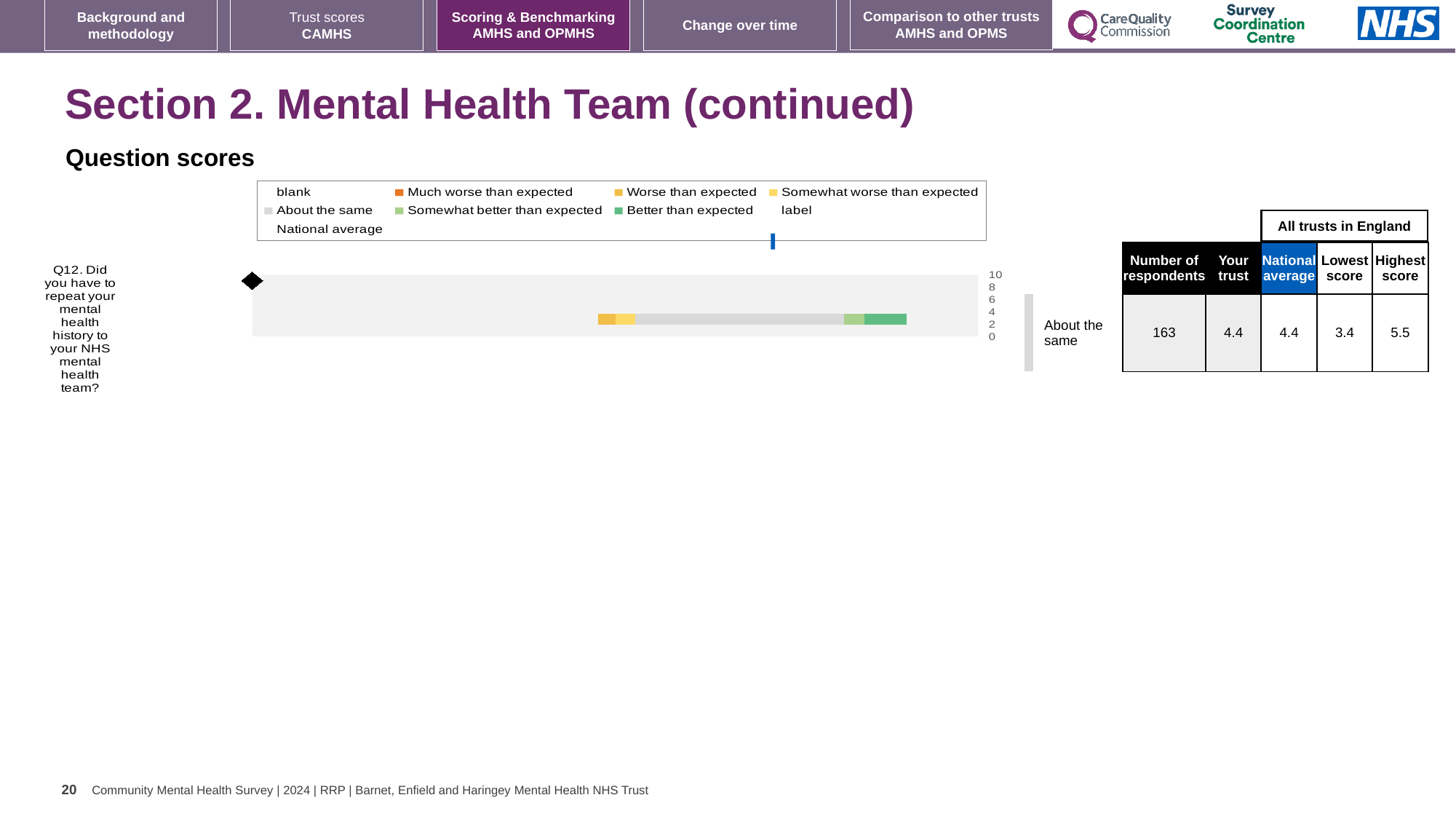
How many questions are plotted on the question scores chart? 1 What is the 'Your trust' score for Q12? 4.4 Is the 'Your trust' score for Q12 higher than, lower than, or the same as the national average? the same What is the highest score among all trusts in England for Q12? 5.5 What kind of chart is used to show the question scores for Q12? bar chart Which question is plotted on the question scores chart? Q12. Did you have to repeat your mental health history to your NHS mental health team? What benchmark category is shown next to the Q12 bar? About the same What is the difference between the 'Your trust' score and the lowest score for Q12? 1.0 What is the lowest score among all trusts in England for Q12? 3.4 What is the national average score for Q12? 4.4 What is the difference between the highest score and the lowest score for Q12? 2.1 How many respondents answered Q12? 163